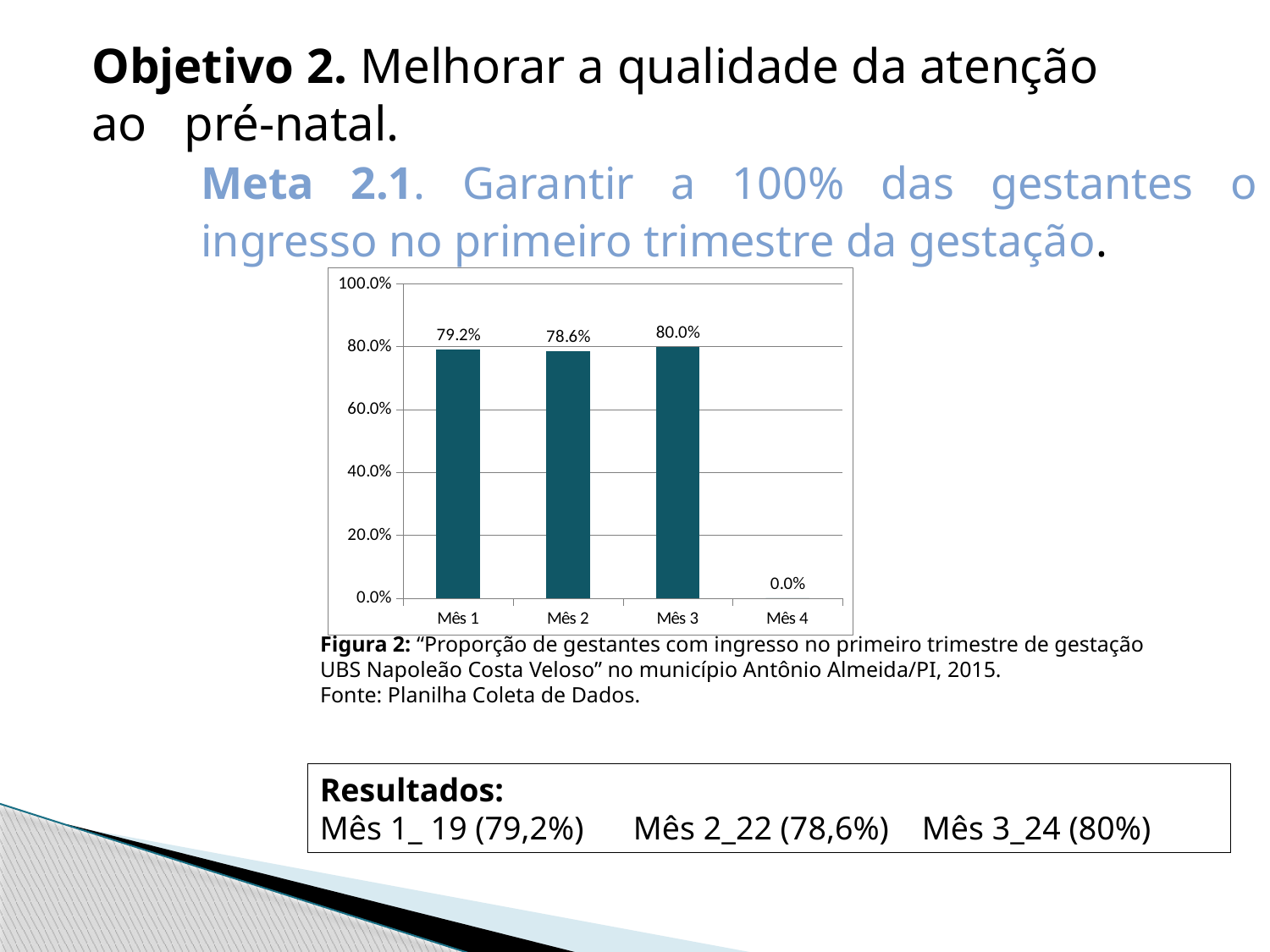
What is the difference between the values for Mês 3 and Mês 2? 1.4% What kind of chart is shown on the slide? bar chart How many categories are shown on the x axis? 4 Which is larger, the value for Mês 1 or the value for Mês 2? Mês 1 Which month has the highest value? Mês 3 What is the figure number given in the caption below the chart? Figura 2 What is the value for Mês 2? 78.6% Is the value for Mês 3 greater or less than 60.0%? greater What is the value for Mês 4? 0.0% Which month has the lowest value? Mês 4 What is the value for Mês 3? 80.0% What is the value for Mês 1? 79.2%